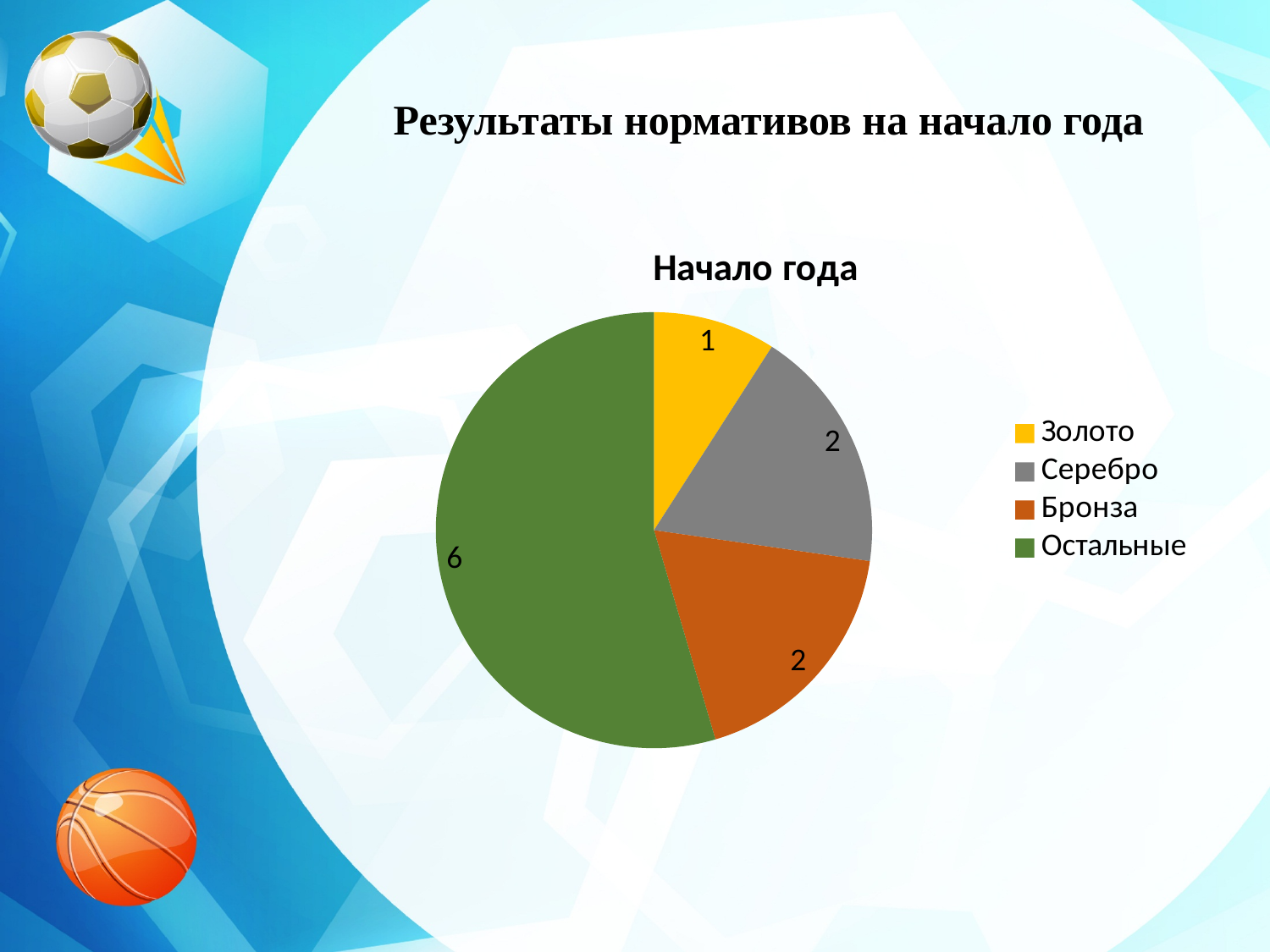
How many categories does the legend list? 4 What type of chart is shown on the slide? pie chart Which category has the smallest slice? Золото What is the value for Бронза? 2 What is the value for Серебро? 2 What is the value for Золото? 1 What is the total of all slices in the pie chart? 11 What is the title of the chart? Начало года Which category has the largest slice? Остальные What is the value for Остальные? 6 Which is larger, the value for Серебро or the value for Золото? Серебро What is the difference between the values for Остальные and Золото? 5